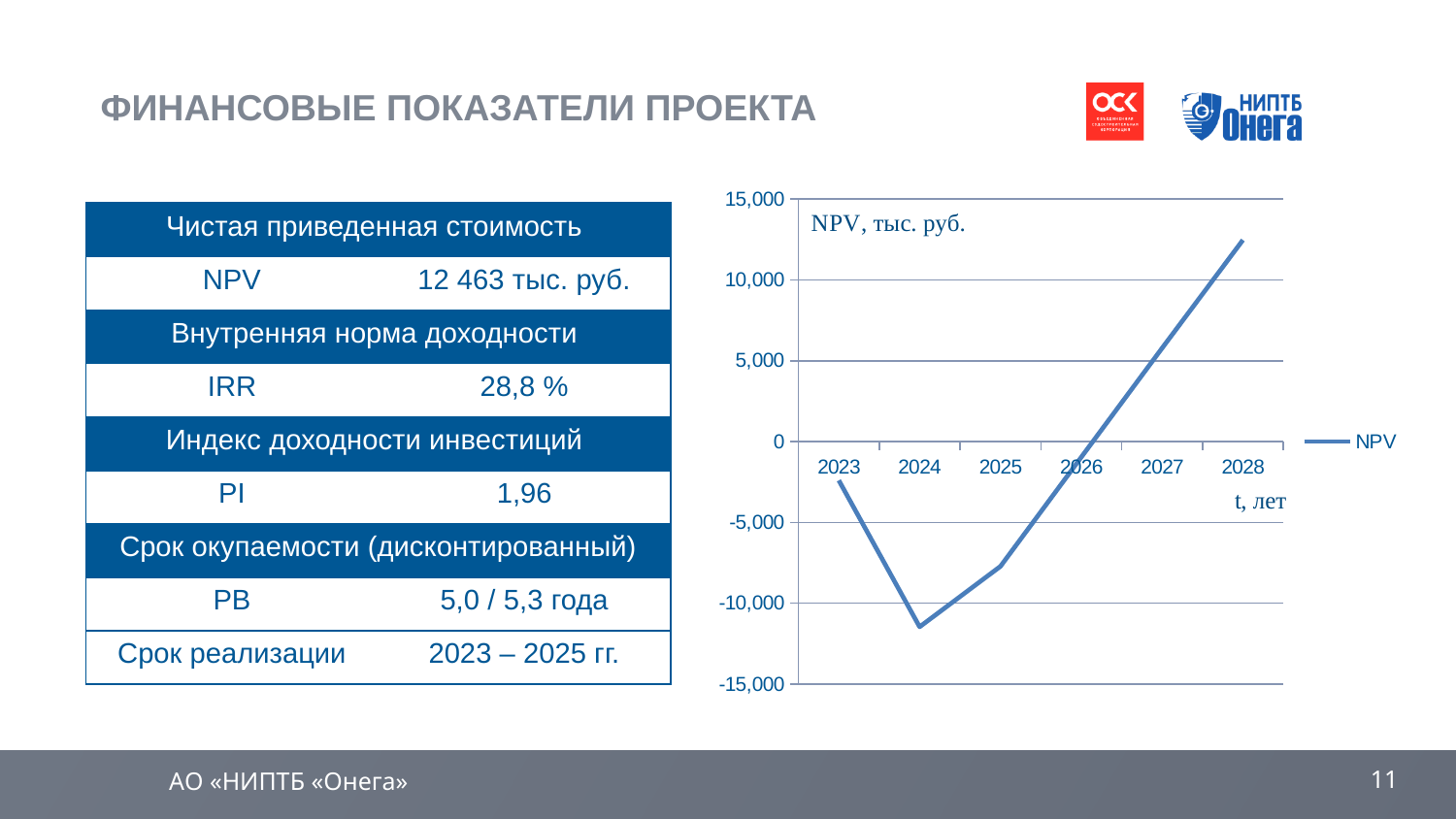
Is the NPV value for 2027 greater or less than 0? greater Which year has the larger NPV value, 2023 or 2024? 2023 What is the name of the series shown in the legend of the chart? NPV How many years are plotted on the x axis of the NPV chart? 6 How many series does the legend of the NPV chart list? 1 What kind of chart is shown on the slide? line chart Is the NPV value for 2028 greater or less than 10,000? greater In which year is the NPV value highest? 2028 In which year is the NPV value lowest? 2024 Is the NPV value for 2025 greater or less than -5,000? less From 2024 to 2028, does the NPV line rise or fall? rise